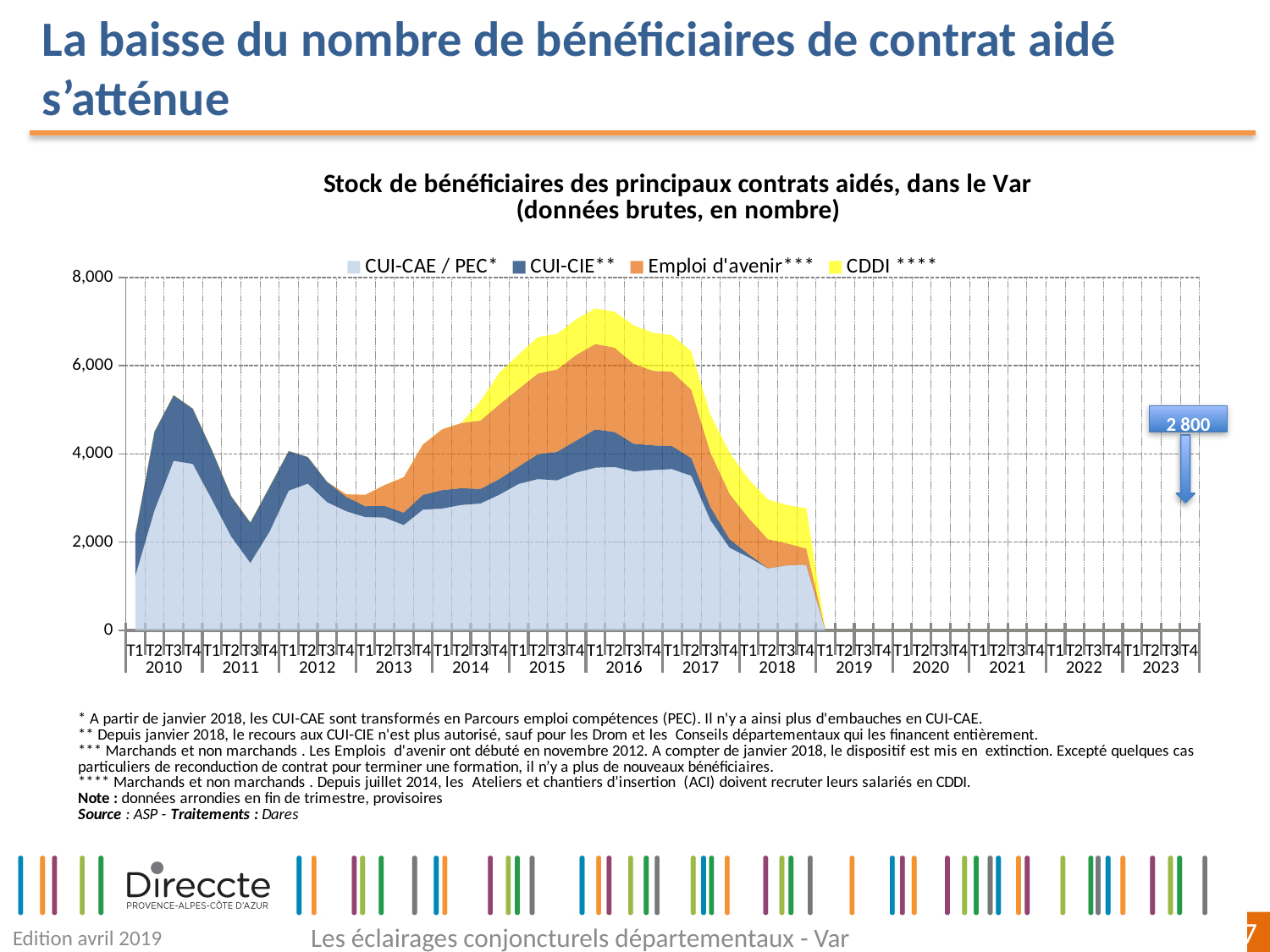
In which year does the total stock of beneficiaries reach its highest level? 2016 Is the total stock at T1 2014 greater or less than 4,000? greater Is the peak total stock reached in 2016 greater or less than 6,000? greater Is the total stock at T1 2016 greater or less than the total stock at T1 2010? greater Is the total stock at T3 2010 greater or less than 4,000? greater How many years are labelled on the x axis? 14 How many series does the legend list? 4 Between 2016 and 2018, does the total stock of beneficiaries rise or fall? fall What value is shown in the annotation box on the right of the chart? 2 800 What kind of chart is shown on the slide? Stacked area chart Which series are listed in the legend? CUI-CAE / PEC*, CUI-CIE**, Emploi d'avenir***, CDDI ****